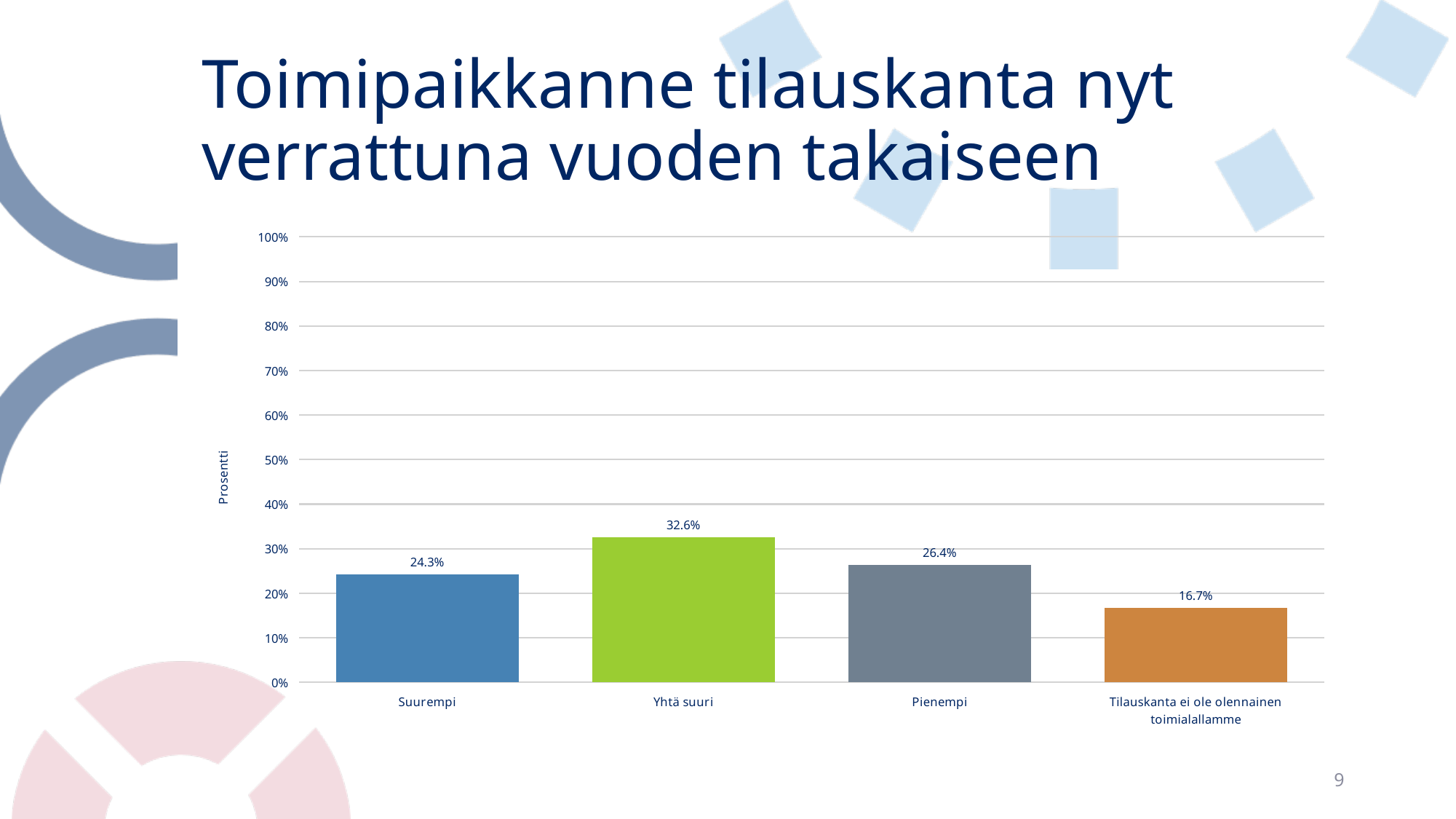
How many categories are shown on the x axis? 4 What is the value for Suurempi? 24.3% What is the difference between the values for Yhtä suuri and Suurempi? 8.3% What is the value for Pienempi? 26.4% Which category has the highest value? Yhtä suuri What is the difference between the values for Pienempi and Tilauskanta ei ole olennainen toimialallamme? 9.7% Which category has the lowest value? Tilauskanta ei ole olennainen toimialallamme Is the value for Yhtä suuri greater or less than 30%? greater Which is larger, the value for Pienempi or the value for Suurempi? Pienempi What kind of chart is shown on the slide? Bar chart What is the value for Tilauskanta ei ole olennainen toimialallamme? 16.7% What is the value for Yhtä suuri? 32.6%